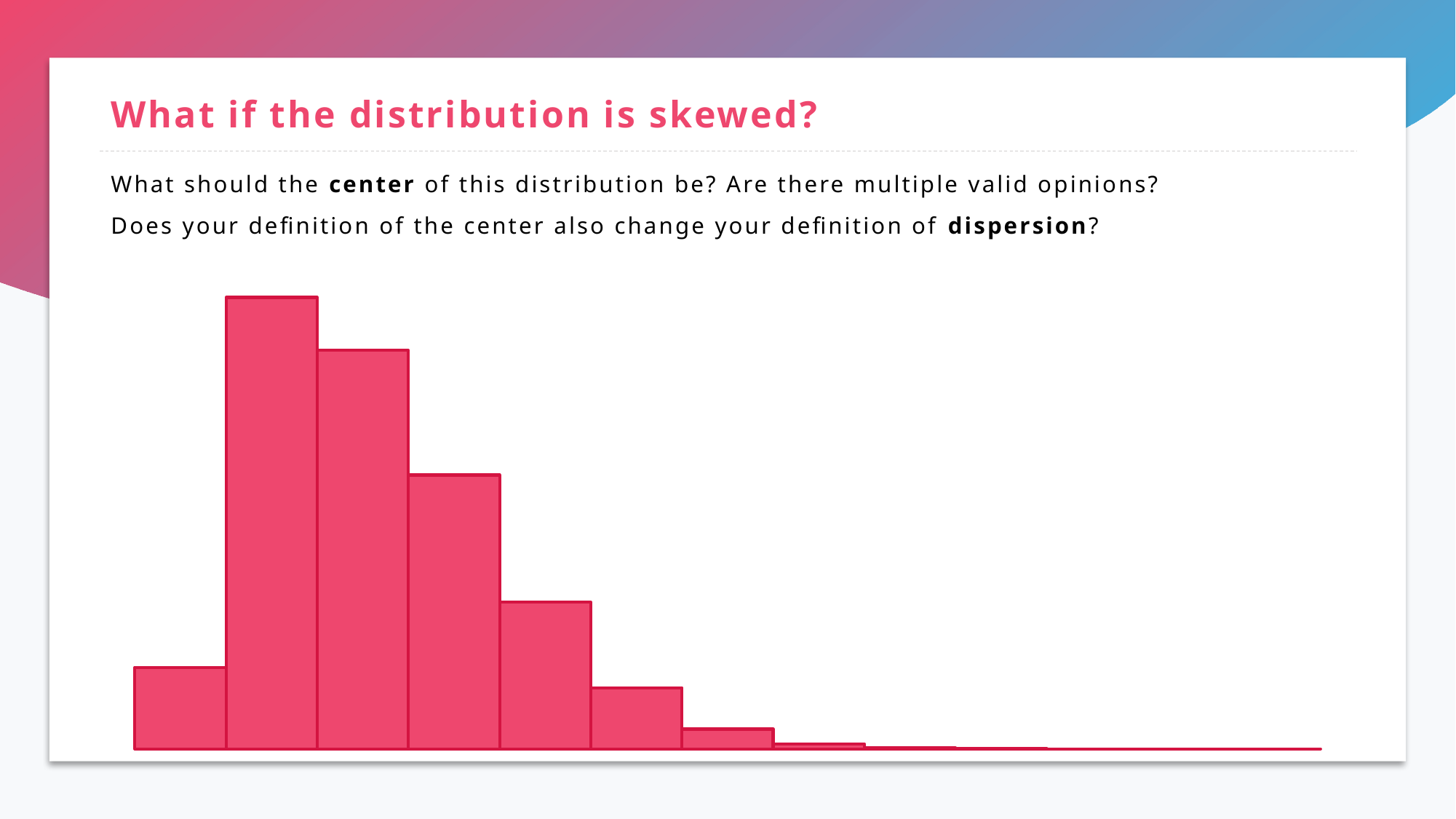
Is the distribution shown in the chart skewed to the left or to the right? to the right After the tallest bar, do the bar heights rise or fall moving to the right along the x axis? fall Counting from the left, which bar in the chart is the tallest? the second bar Is the first bar from the left taller or shorter than the second bar? shorter What is the title of the slide containing the chart? What if the distribution is skewed? What kind of chart is shown on the slide? bar chart (histogram) What colour are the bars in the chart? pink/red Is the third bar from the left taller or shorter than the fourth bar? taller